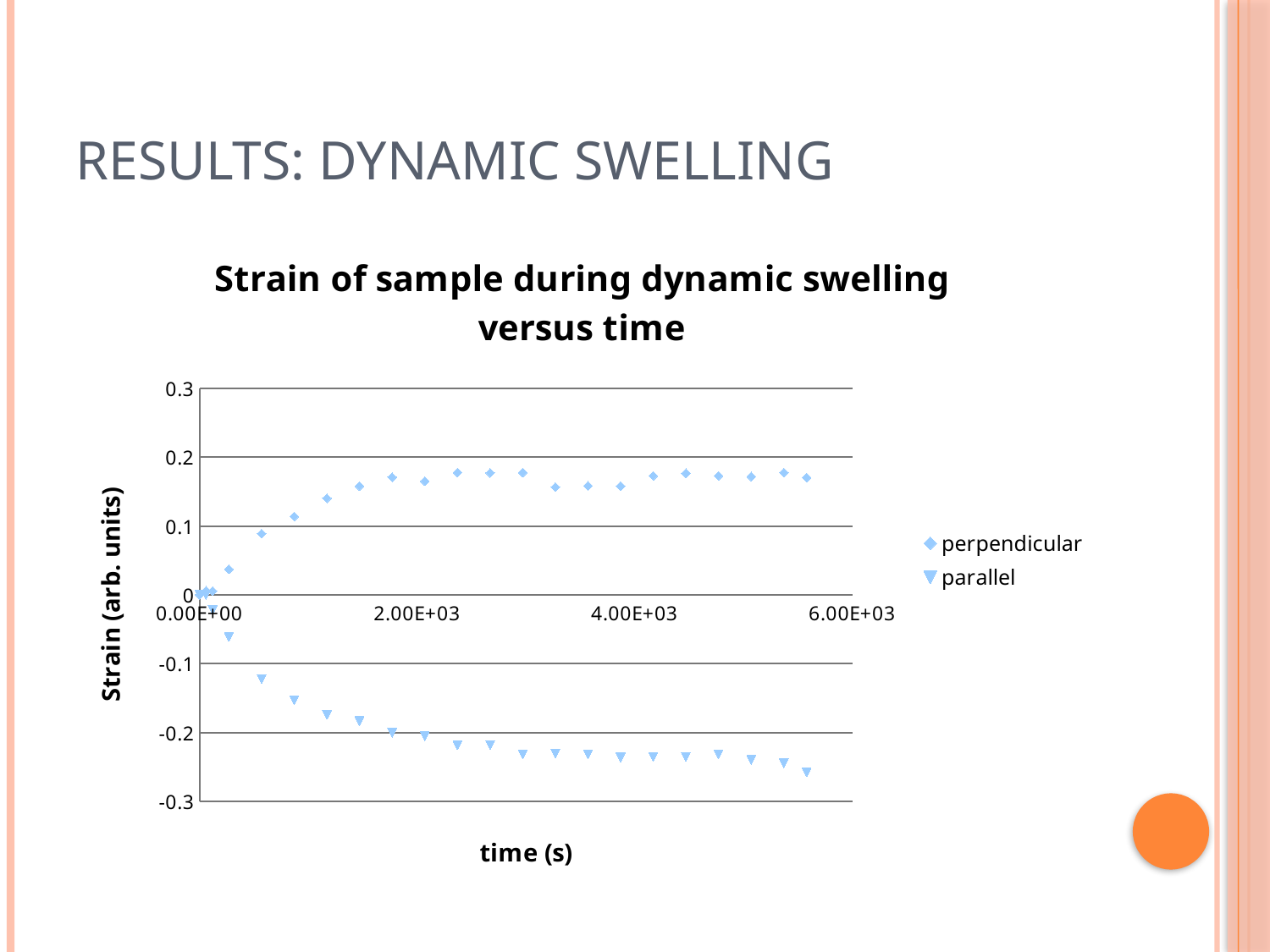
Is the perpendicular strain at a time of 4.00E+03 s greater or less than 0.1? greater Do the perpendicular strain values rise or fall as time increases from 0 to about 2.00E+03 s? rise Is the parallel strain at a time of 4.00E+03 s greater or less than -0.2? less What kind of chart is shown on the slide? scatter chart How many series does the legend list? 2 Is the parallel strain at a time of 2.00E+03 s greater or less than -0.1? less At a time of 4.00E+03 s, which series has the larger strain value, perpendicular or parallel? perpendicular What are the two series named in the legend? perpendicular and parallel What is the title of the chart? Strain of sample during dynamic swelling versus time Which series has negative strain values throughout most of the time range? parallel Do the parallel strain values rise or fall as time increases from 0 to about 2.00E+03 s? fall